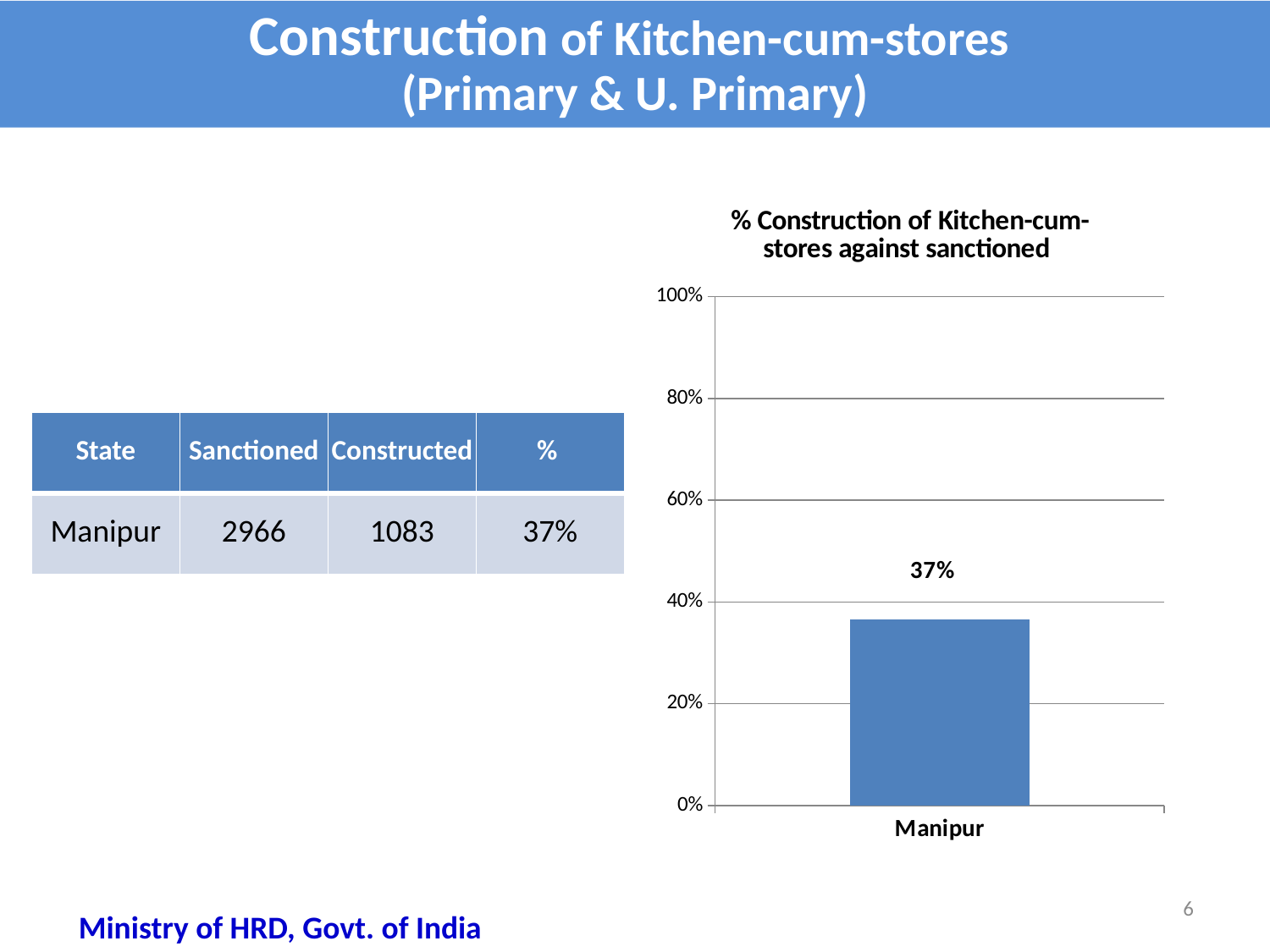
Is the value for Manipur greater or less than 40%? less What is the title of the chart? % Construction of Kitchen-cum-stores against sanctioned Is the value for Manipur greater or less than 20%? greater What is the value shown for Manipur in the chart? 37% What kind of chart is shown on the slide? bar chart What is the highest value shown on the chart's vertical axis? 100% Which state is shown on the chart's x axis? Manipur How many categories are plotted in the chart? 1